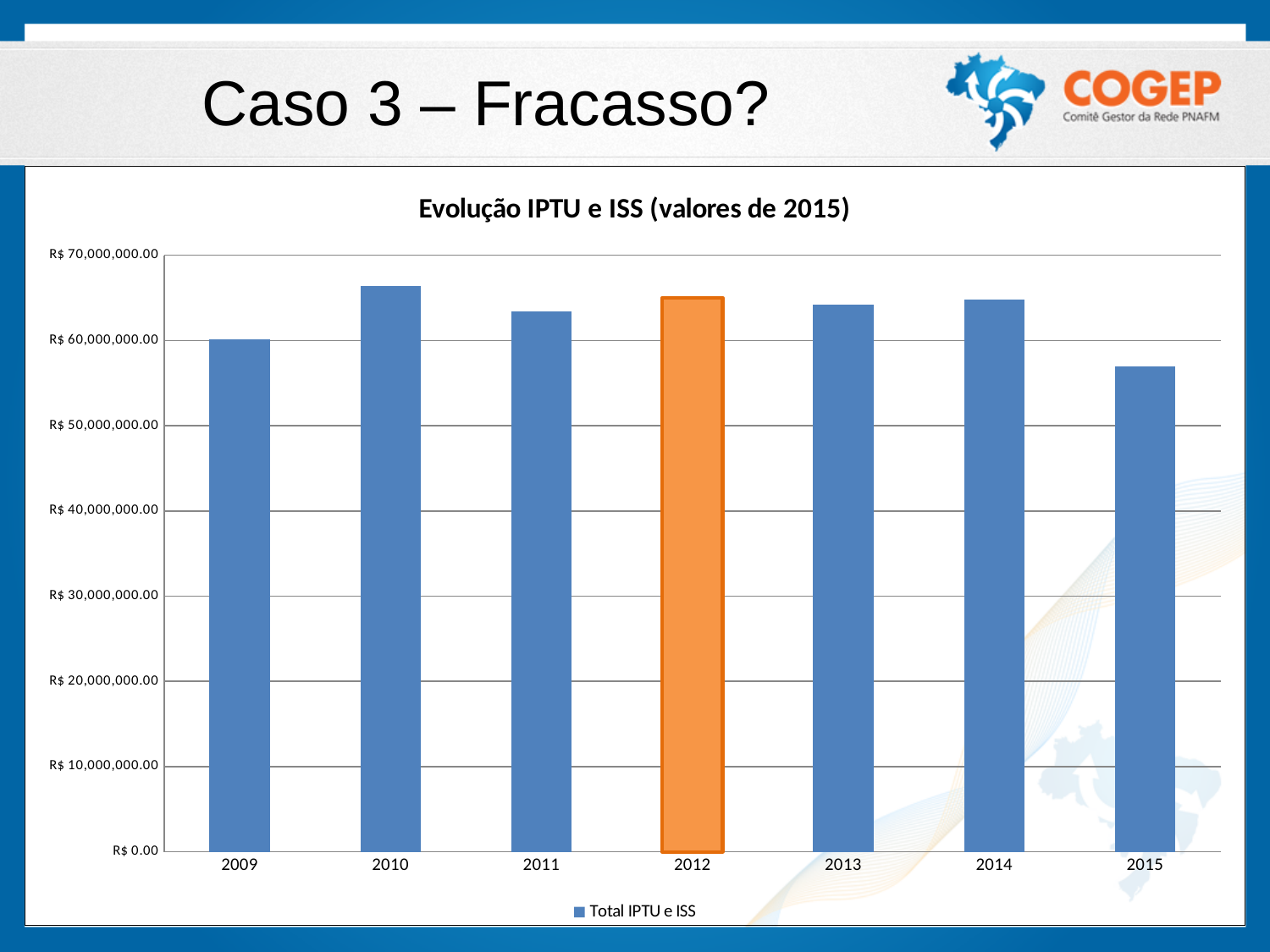
Which year's bar is highlighted in orange? 2012 Which year has the lowest value in the chart? 2015 What is the title of the chart? Evolução IPTU e ISS (valores de 2015) Does the value rise or fall from 2014 to 2015? fall Is the value for 2015 greater or less than R$ 60,000,000.00? less How many years are shown on the x axis of the chart? 7 Which is larger, the value for 2009 or the value for 2011? 2011 How many series does the legend list? 1 Is the value for 2009 greater or less than R$ 50,000,000.00? greater What kind of chart is shown on the slide? bar chart Is the value for 2010 greater or less than R$ 60,000,000.00? greater Which is larger, the value for 2010 or the value for 2015? 2010